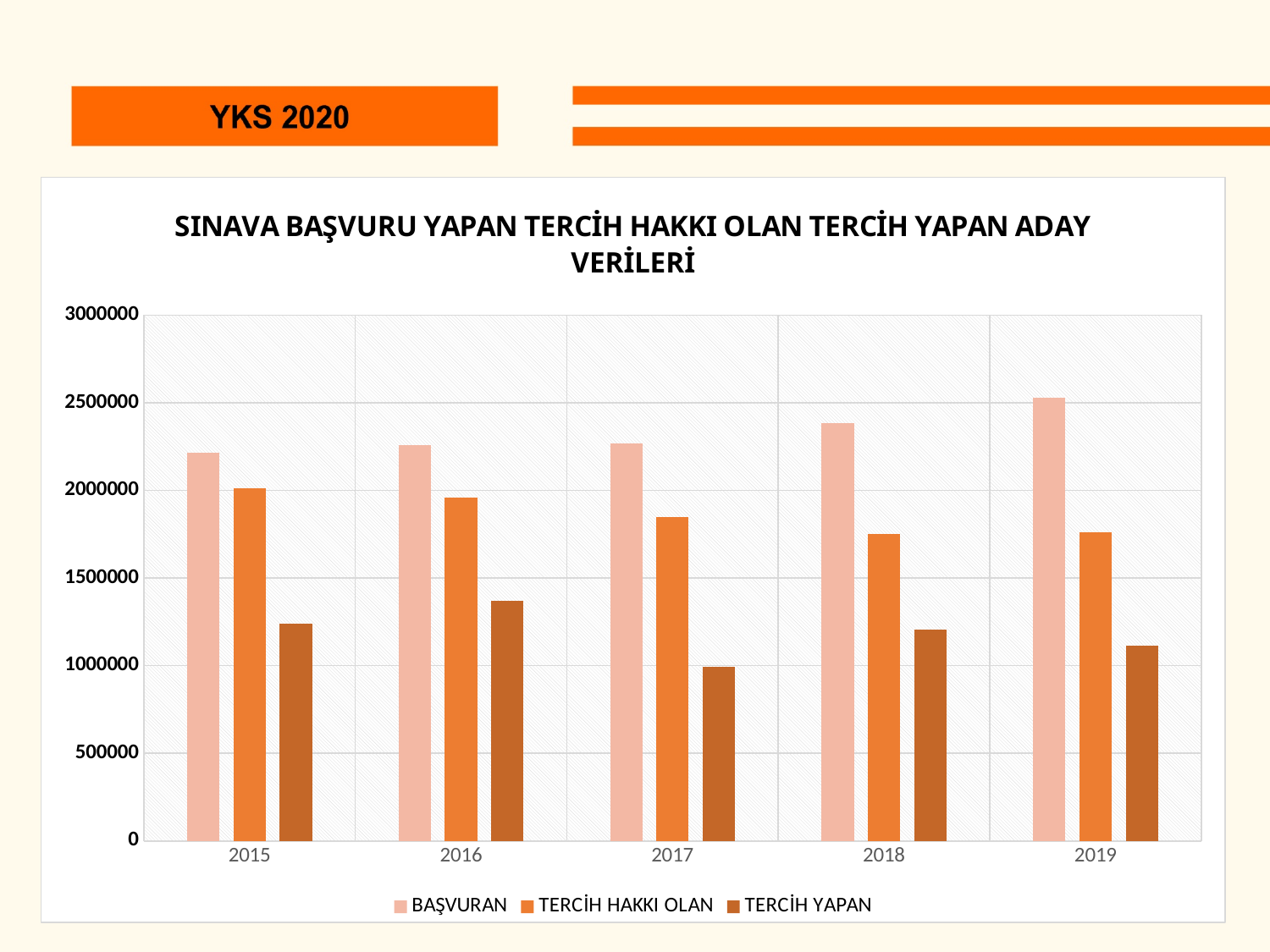
Does the BAŞVURAN series rise or fall from 2015 to 2019? Rises Is the TERCİH HAKKI OLAN value for 2017 greater or less than 2000000? less In which year is the TERCİH HAKKI OLAN value highest? 2015 In which year is the BAŞVURAN value highest? 2019 How many series does the chart legend list? 3 Is the TERCİH YAPAN value for 2016 greater or less than 1000000? greater In which year is the TERCİH YAPAN value highest? 2016 How many years are shown on the x axis of the chart? 5 Which is larger: the TERCİH HAKKI OLAN value for 2016 or for 2018? 2016 In which year is the TERCİH YAPAN value lowest? 2017 Is the BAŞVURAN value for 2018 greater or less than 2500000? less What kind of chart is shown on the slide? Bar chart